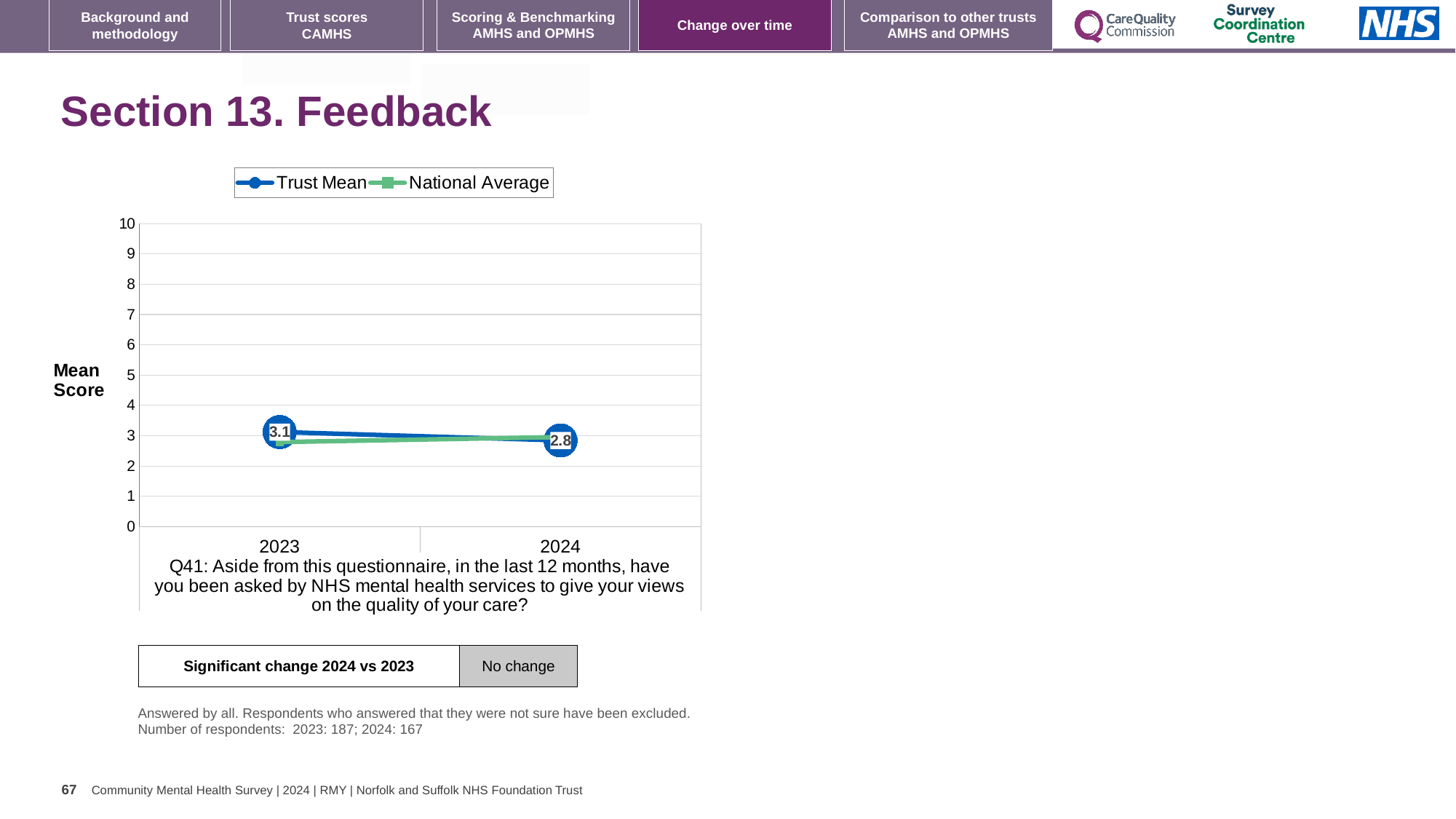
What kind of chart is shown on the slide? line chart What is the label on the y axis of the chart? Mean Score How many years are plotted on the x axis? 2 Does the Trust Mean rise or fall from 2023 to 2024? fall What is the Trust Mean value for 2023? 3.1 In which year is the Trust Mean at its highest? 2023 What is the Trust Mean value for 2024? 2.8 Is the National Average value for 2024 greater or less than 1? greater Which year has the higher Trust Mean, 2023 or 2024? 2023 Is the National Average value for 2023 greater or less than 4? less By how much did the Trust Mean change from 2023 to 2024? 0.3 How many series does the legend list? 2